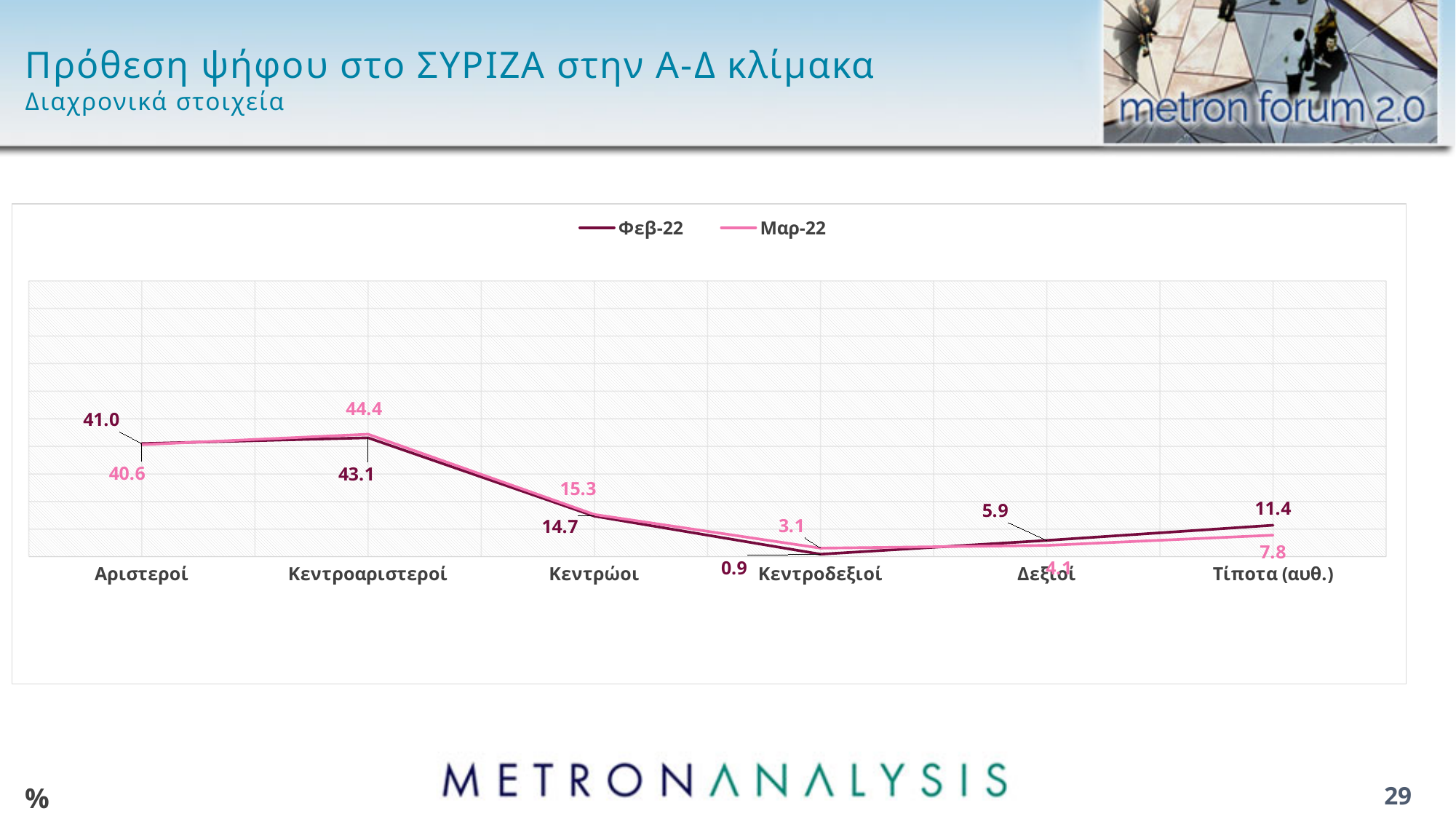
How many series does the legend list? 2 What is the difference between the Μαρ-22 and Φεβ-22 values for Κεντροαριστεροί? 1.3 What is the Μαρ-22 value for Κεντροαριστεροί? 44.4 What is the Φεβ-22 value for Αριστεροί? 41.0 Which series is drawn in pink? Μαρ-22 Which category has the highest Μαρ-22 value? Κεντροαριστεροί What is the Μαρ-22 value for Τίποτα (αυθ.)? 7.8 Which category has the lowest Φεβ-22 value? Κεντροδεξιοί What kind of chart is shown on the slide? Line chart What is the Φεβ-22 value for Κεντροδεξιοί? 0.9 For Τίποτα (αυθ.), which series has the larger value, Φεβ-22 or Μαρ-22? Φεβ-22 How many categories are shown on the x axis? 6